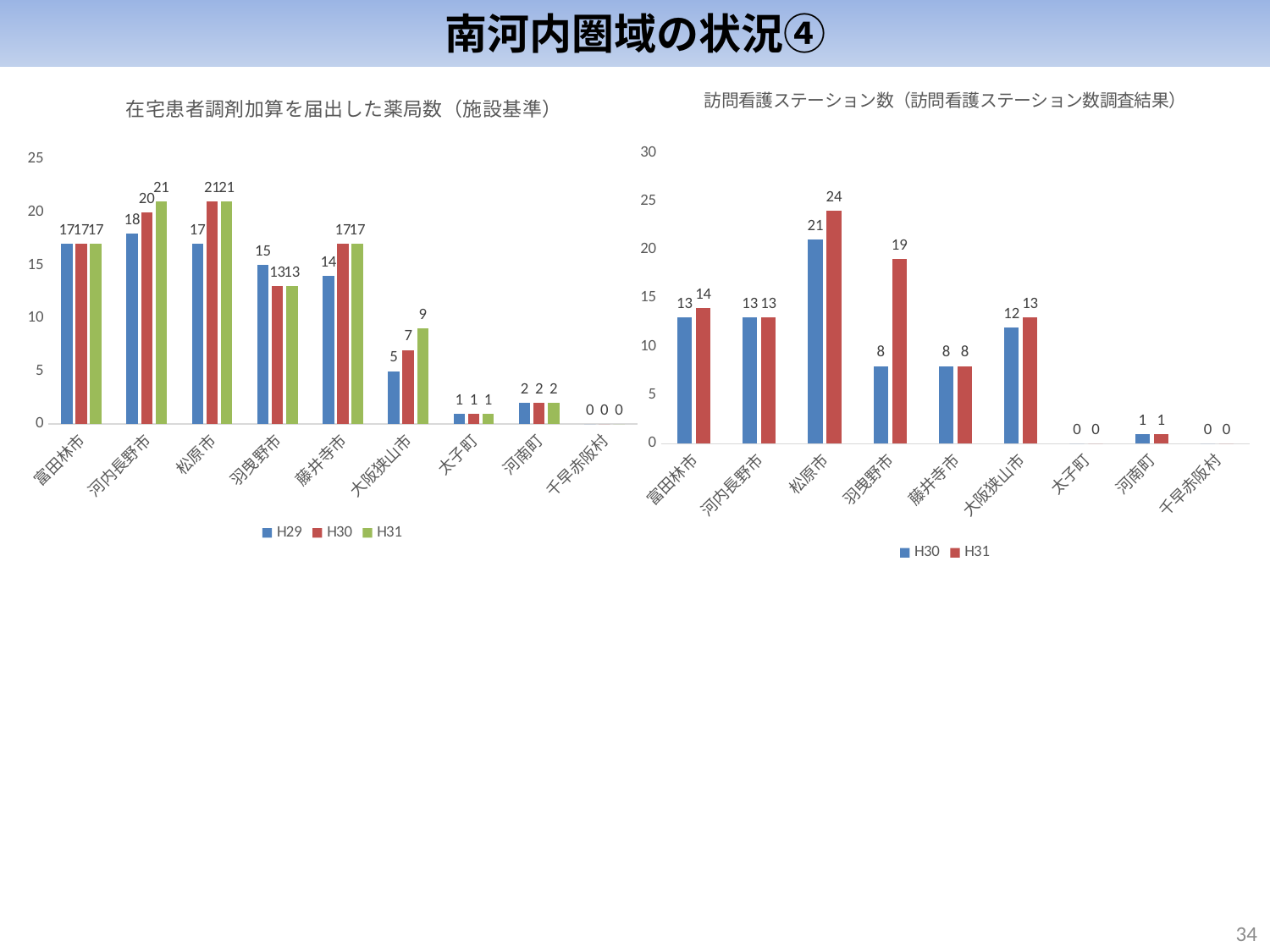
What type of chart is the right chart (訪問看護ステーション数)? bar chart In the right chart (訪問看護ステーション数), what is the H30 value for 羽曳野市? 8 In the left chart (在宅患者調剤加算を届出した薬局数), do the values for 羽曳野市 rise or fall from H29 to H31? fall In the right chart (訪問看護ステーション数), which category has the highest H31 value? 松原市 In the left chart (在宅患者調剤加算を届出した薬局数), what is the difference between the H31 and H29 values for 大阪狭山市? 4 In the right chart (訪問看護ステーション数), how many categories are shown on the x axis? 9 In the left chart (在宅患者調剤加算を届出した薬局数), what is the H29 value for 大阪狭山市? 5 In the left chart (在宅患者調剤加算を届出した薬局数), which category has the lowest values across all series? 千早赤阪村 In the left chart (在宅患者調剤加算を届出した薬局数), how many series does the legend list? 3 In the right chart (訪問看護ステーション数), what is the difference between the H31 and H30 values for 羽曳野市? 11 In the right chart (訪問看護ステーション数), what is the H31 value for 松原市? 24 In the left chart (在宅患者調剤加算を届出した薬局数), what is the H31 value for 河内長野市? 21